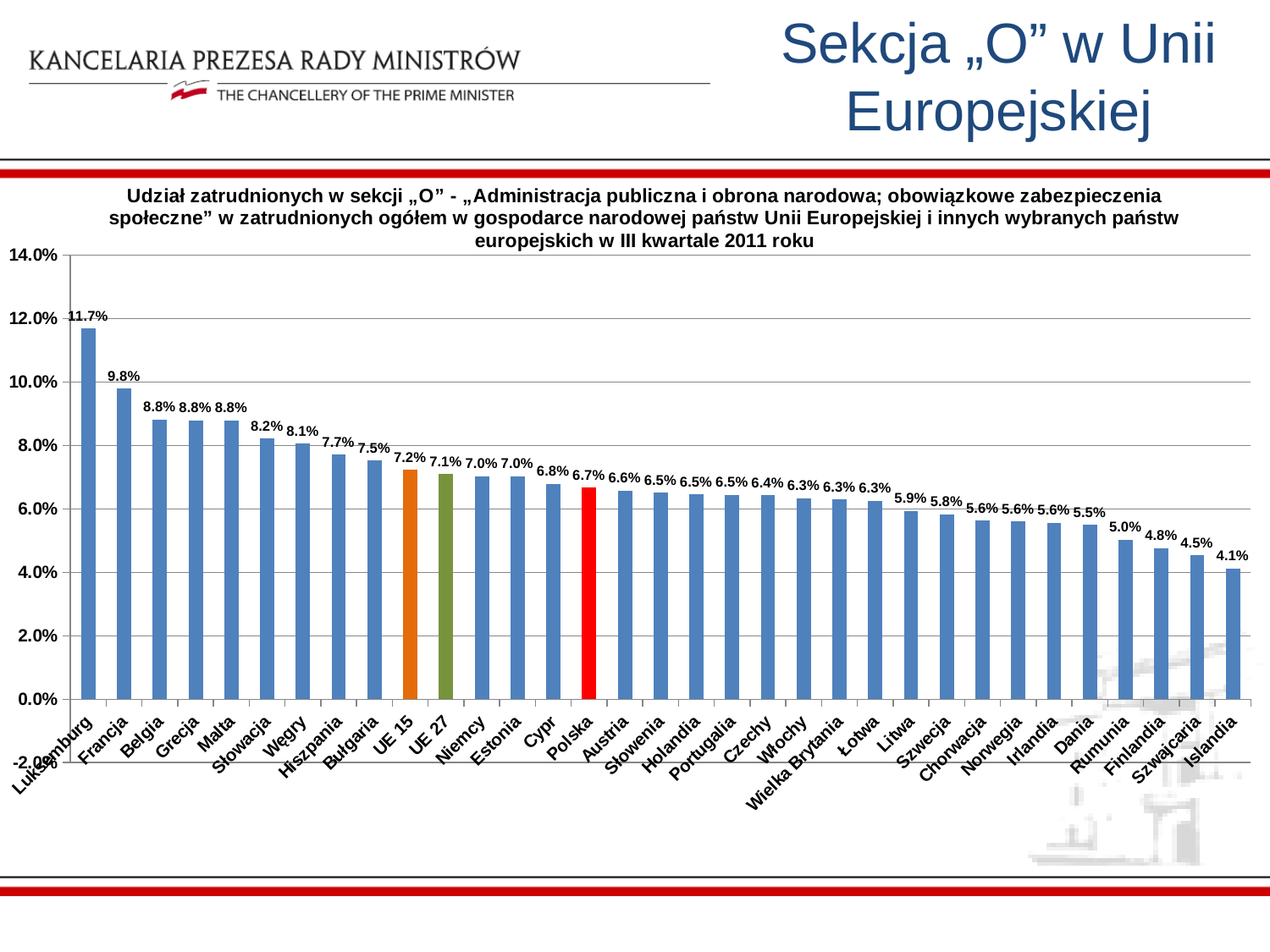
Which category has the highest value? Luksemburg What colour is the bar for Polska? Red What is the value for Polska? 6.7% What is the difference between the values for Luksemburg and Polska? 5.0 percentage points Which category has the lowest value? Islandia Do the values rise or fall from left to right along the x axis? Fall What is the value for Luksemburg? 11.7% What kind of chart is shown on the slide? Bar chart How many categories are plotted on the chart? 33 What is the value for UE 27? 7.1% What is the difference between the values for UE 15 and Polska? 0.5 percentage points Which is larger, the value for Francja or the value for Belgia? Francja